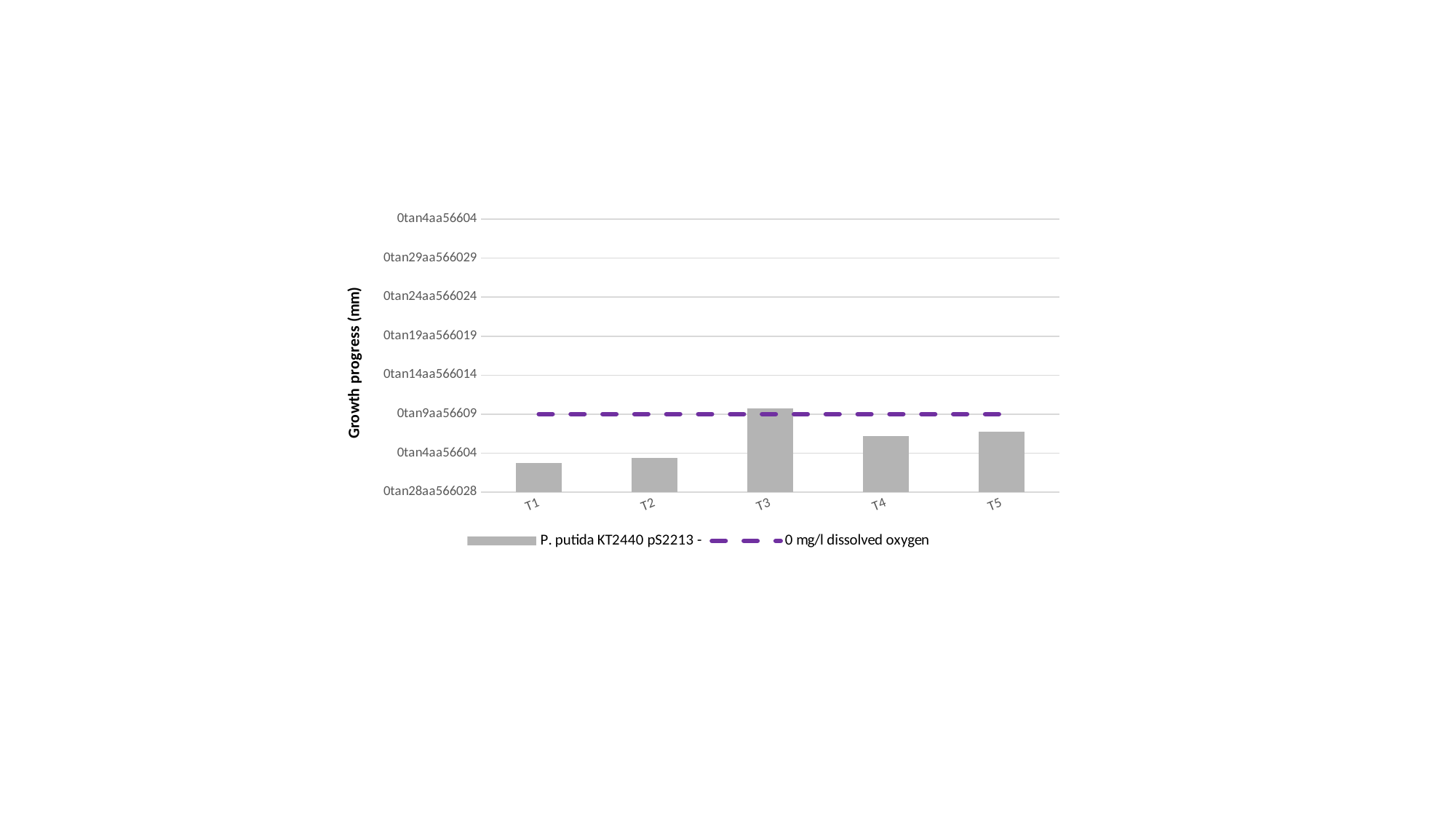
Which category has the tallest bar? T3 Which category has the shortest bar? T1 Which bar is taller, T2 or T5? T5 Which category's bar reaches above the dashed line? T3 How many categories are shown on the x axis? 5 Which bar is taller, T3 or T1? T3 What does the purple dashed line represent according to the legend? 0 mg/l dissolved oxygen What kind of chart is shown on the slide? combination bar and line chart How many series does the legend list? 2 What is the title of the y axis? Growth progress (mm) Do the bars rise or fall from T1 to T3? rise